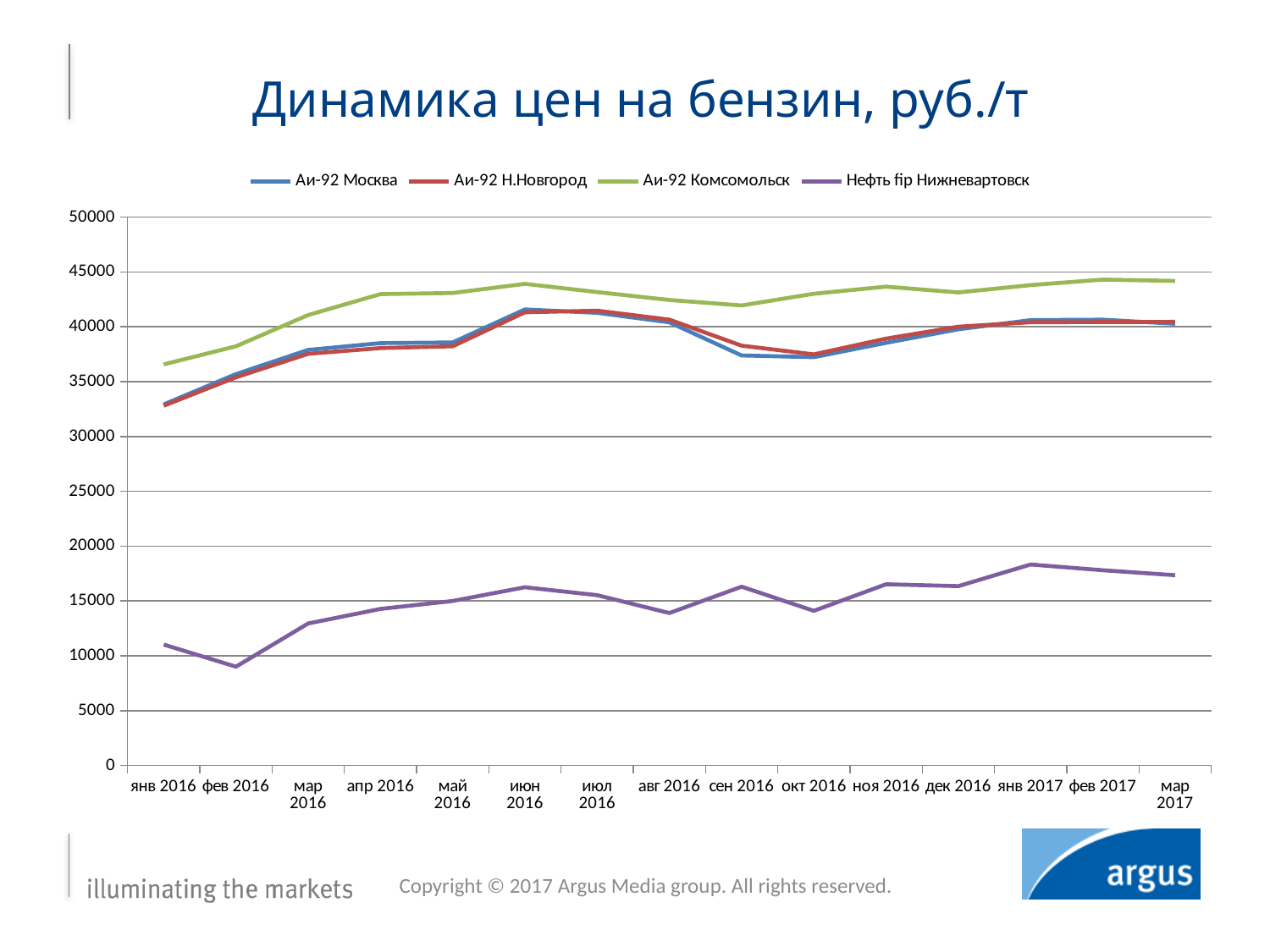
What is the title of the chart? Динамика цен на бензин, руб./т How many series does the legend list? 4 For Нефть fip Нижневартовск, which month has the larger value: сен 2016 or окт 2016? сен 2016 Is the value for Нефть fip Нижневартовск in фев 2016 greater or less than 10000? less How many months are plotted along the x axis? 15 Is the value for Аи-92 Москва in янв 2016 greater or less than 35000? less Is the value for Аи-92 Москва in сен 2016 greater or less than 40000? less In which month is the value for Нефть fip Нижневартовск lowest? фев 2016 What kind of chart is shown on the slide? line chart Which series has the highest values across the whole period? Аи-92 Комсомольск Overall, does the Нефть fip Нижневартовск line rise or fall from янв 2016 to мар 2017? rise